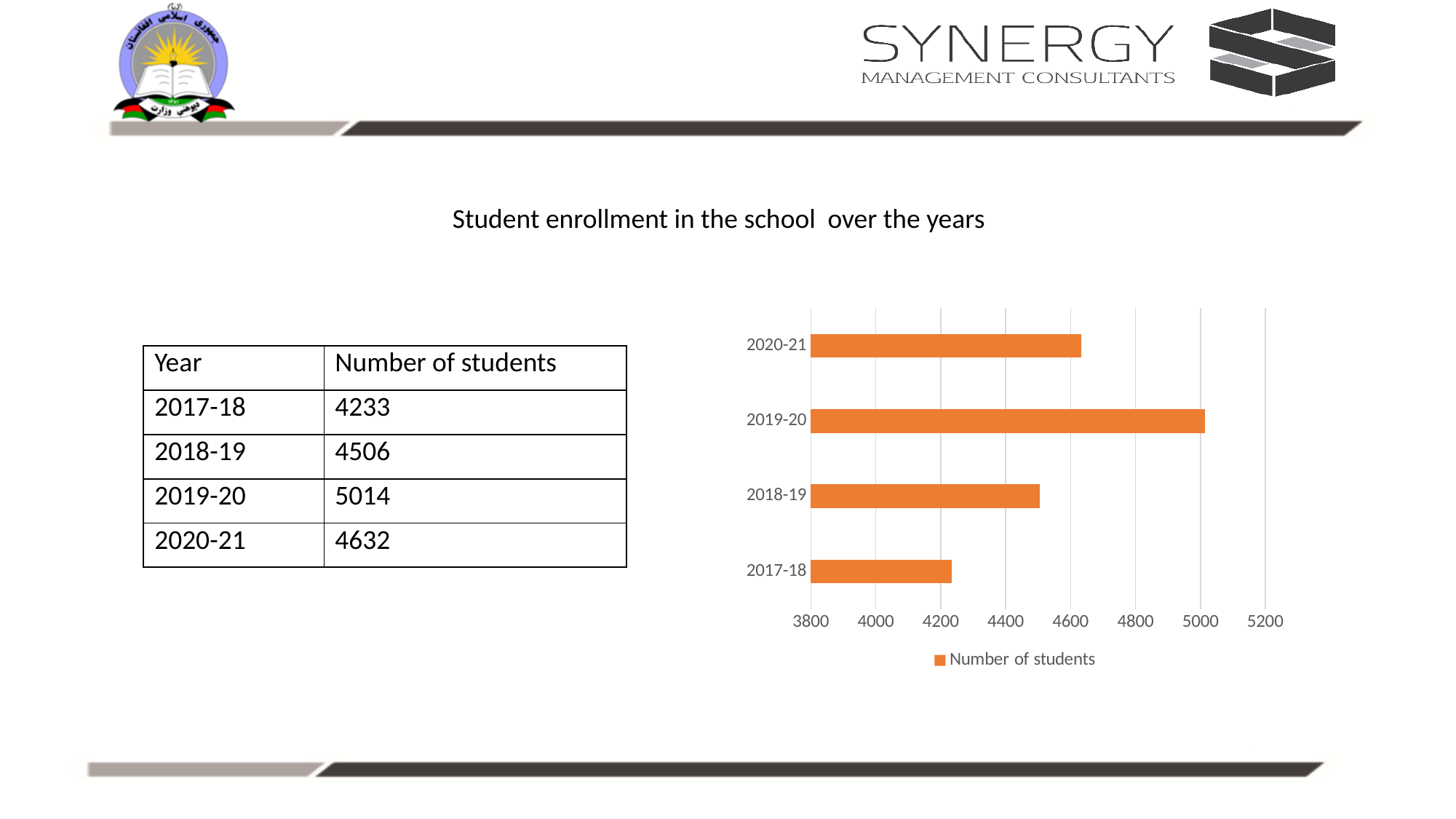
What is the number of students for 2019-20? 5014 Which year has the highest number of students? 2019-20 Is the number of students for 2018-19 greater or less than 4600? less Which year has the lowest number of students? 2017-18 What kind of chart is shown on the slide? bar chart What is the name of the series shown in the chart legend? Number of students Which year has more students, 2018-19 or 2020-21? 2020-21 What is the number of students for 2020-21? 4632 Is the number of students for 2019-20 greater or less than 5000? greater How many years (categories) does the bar chart show? 4 What is the difference in the number of students between 2019-20 and 2017-18? 781 How many series does the chart legend list? 1